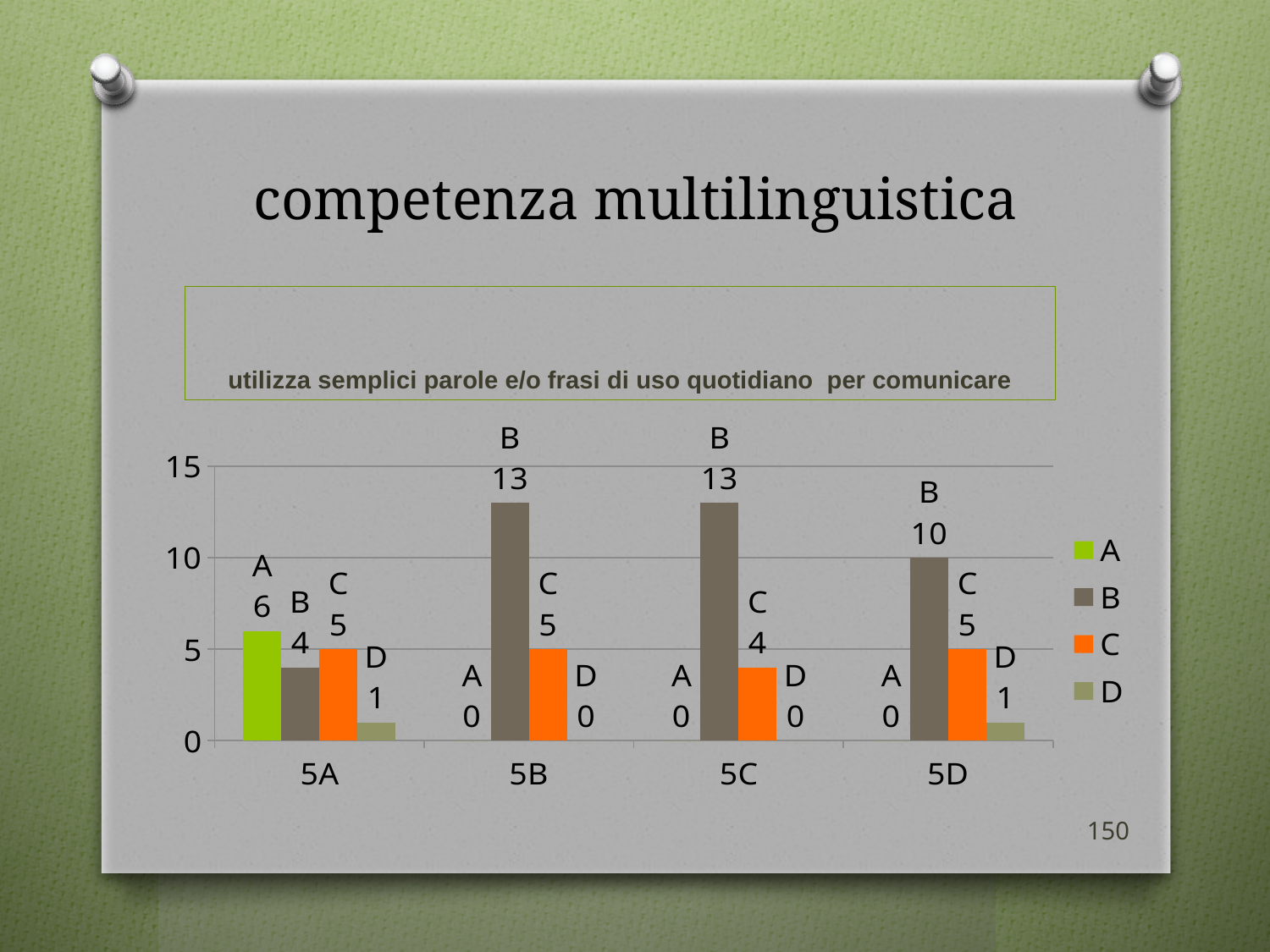
What is the value of series A for category 5A? 6 What is the value of series D for category 5D? 1 How many series does the legend list? 4 Which category has the lowest value for series B? 5A Which is larger: series A for 5A or series B for 5A? series A for 5A What is the value of series B for category 5B? 13 What is the value of series C for category 5C? 4 How many categories are shown on the x axis? 4 What kind of chart is shown on the slide? bar chart Which category has the highest value for series B? 5B and 5C What is the difference between series B for 5B and series B for 5D? 3